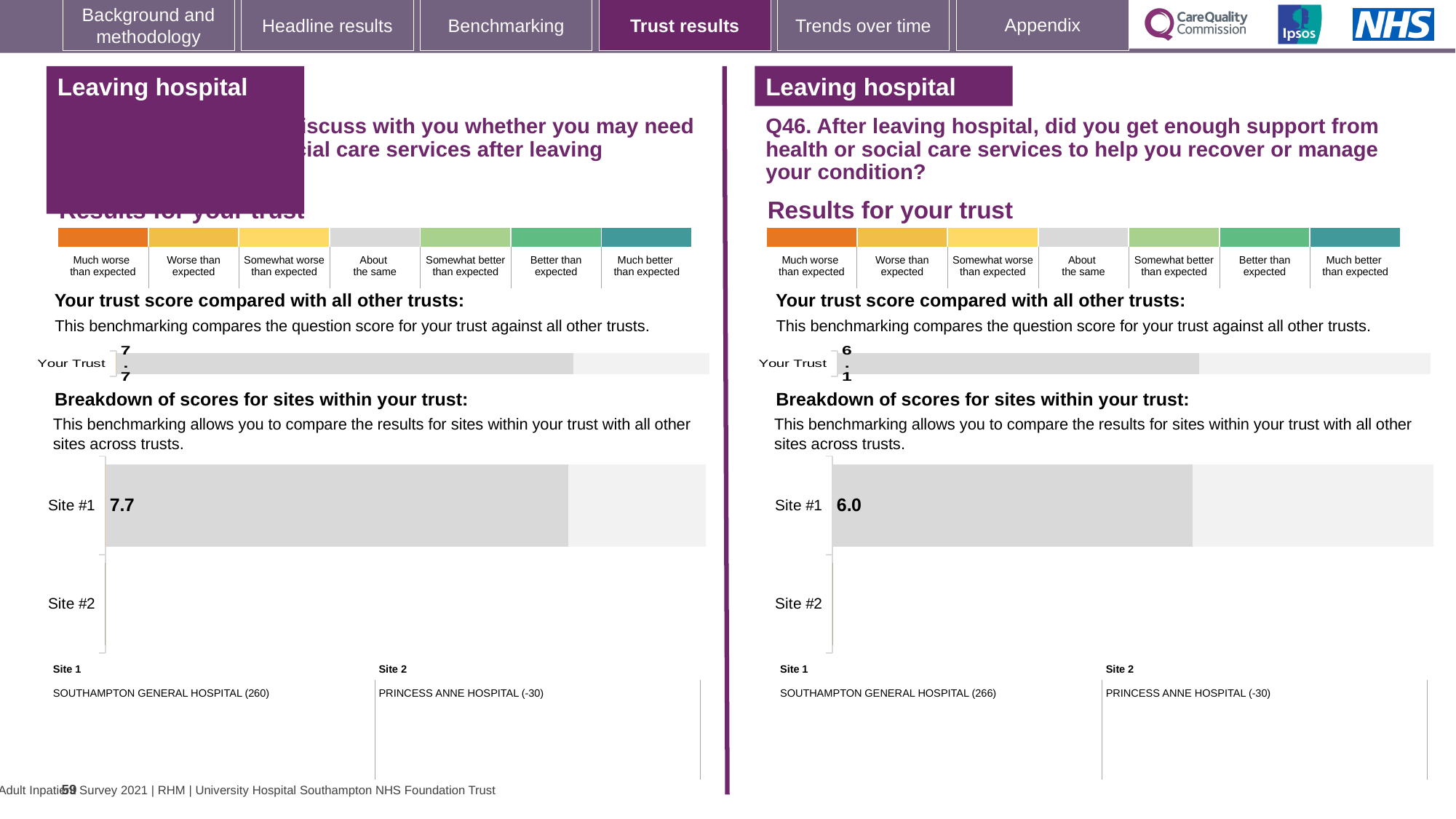
Which hospital is listed as Site 1 beneath the right breakdown chart? SOUTHAMPTON GENERAL HOSPITAL (266) What type of chart is used for the 'Breakdown of scores for sites within your trust' on the left half of the slide? Bar chart In the right 'Breakdown of scores for sites within your trust' chart (Q46), what is the value for Site #1? 6.0 Which is larger: the Site #1 value in the left breakdown chart or the Site #1 value in the right breakdown chart? Left (7.7) On the left half of the slide, what is the value shown for Your Trust in the 'Your trust score compared with all other trusts' chart? 7.7 In the left 'Breakdown of scores for sites within your trust' chart, what is the value for Site #1? 7.7 What is the difference between the Your Trust score on the right half (6.1) and the Site #1 score on the right half (6.0)? 0.1 Which hospital is listed as Site 2 beneath the left breakdown chart? PRINCESS ANNE HOSPITAL (-30) How many site categories are listed in the right 'Breakdown of scores for sites within your trust' chart? 2 What is the difference between the Site #1 value in the left breakdown chart (7.7) and the Site #1 value in the right breakdown chart (6.0)? 1.7 In the left breakdown chart, which site has the highest score shown? Site #1 On the right half of the slide (Q46), what is the value shown for Your Trust in the 'Your trust score compared with all other trusts' chart? 6.1